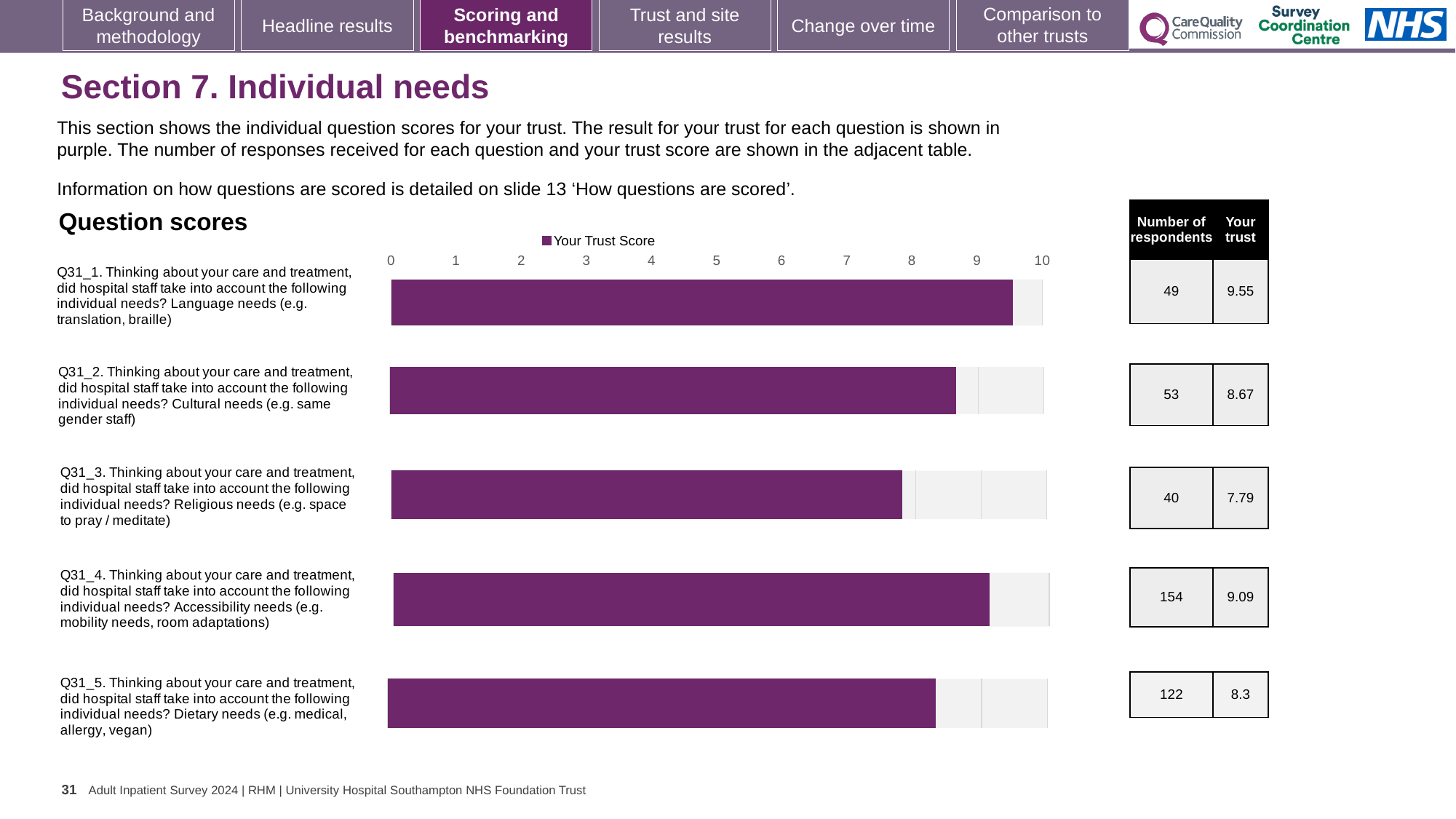
What series does the chart legend list? Your Trust Score How many respondents answered Q31_4 (Accessibility needs)? 154 How many questions are plotted in the chart? 5 Which question has the highest trust score? Q31_1 (Language needs) What is the trust score for Q31_1 (Language needs)? 9.55 What is the trust score for Q31_5 (Dietary needs)? 8.3 Which question has the lowest trust score? Q31_3 (Religious needs) Which has the higher trust score, Q31_2 (Cultural needs) or Q31_4 (Accessibility needs)? Q31_4 (Accessibility needs) Is the trust score for Q31_5 (Dietary needs) greater or less than 9? less What is the trust score for Q31_3 (Religious needs)? 7.79 What type of chart is shown on the slide? Bar chart What is the difference between the trust scores for Q31_1 (Language needs) and Q31_3 (Religious needs)? 1.76